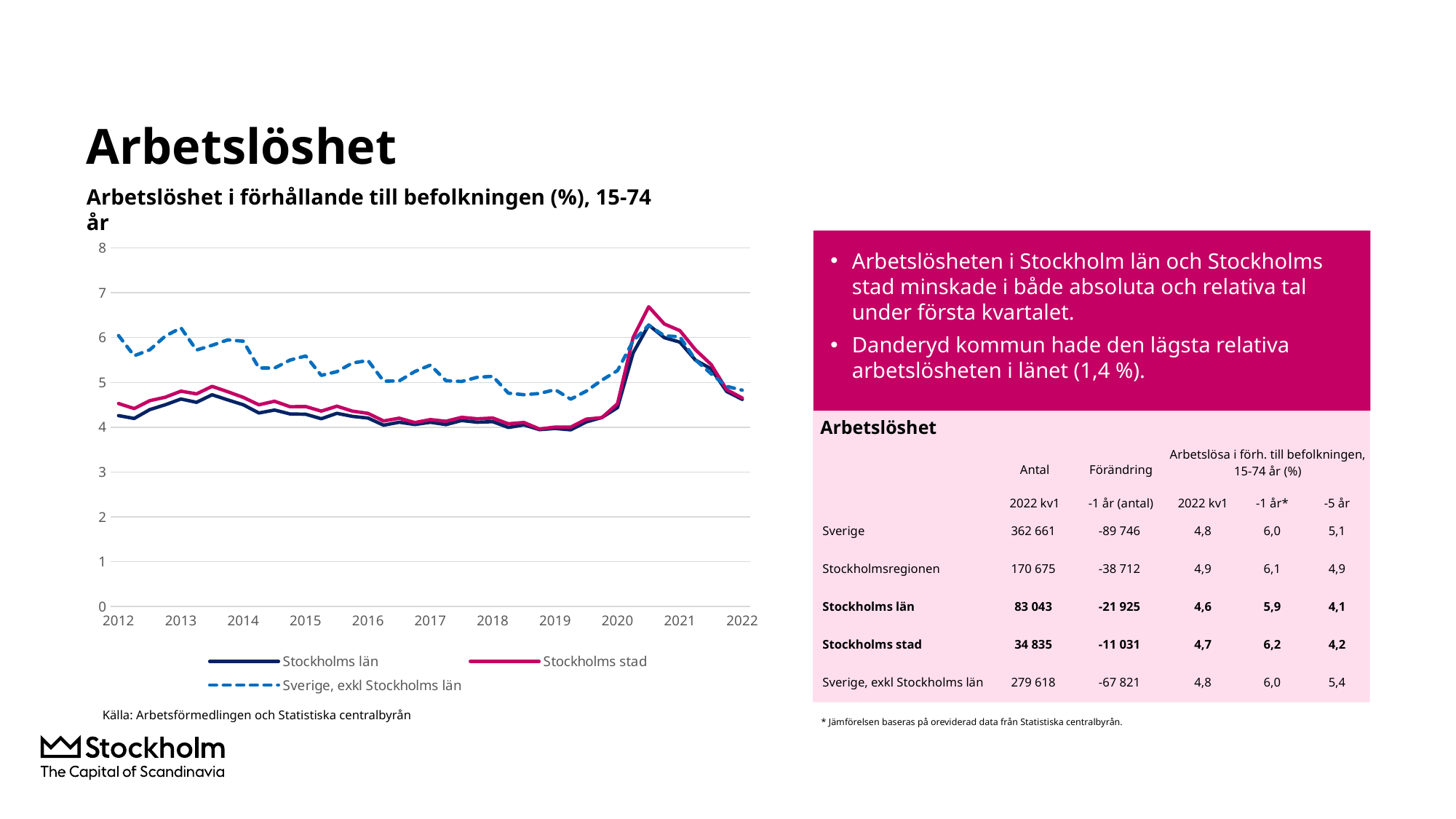
What is the title of the chart? Arbetslöshet i förhållande till befolkningen (%), 15-74 år Is the value for Stockholms län in 2016 greater or less than 5? less Which series has the highest value in 2012? Sverige, exkl Stockholms län How many year labels are shown on the x axis of the chart? 11 Is the value for Sverige, exkl Stockholms län in 2013 greater or less than 5? greater Is the value for Stockholms stad at its 2020 peak greater or less than 6? greater Which series is drawn with a dashed line in the chart? Sverige, exkl Stockholms län In 2012, which is larger: the value for Sverige, exkl Stockholms län or the value for Stockholms län? Sverige, exkl Stockholms län What kind of chart is shown on the slide? line chart Do the values for Stockholms län rise or fall from the 2020 peak to 2022? fall How many series does the chart legend list? 3